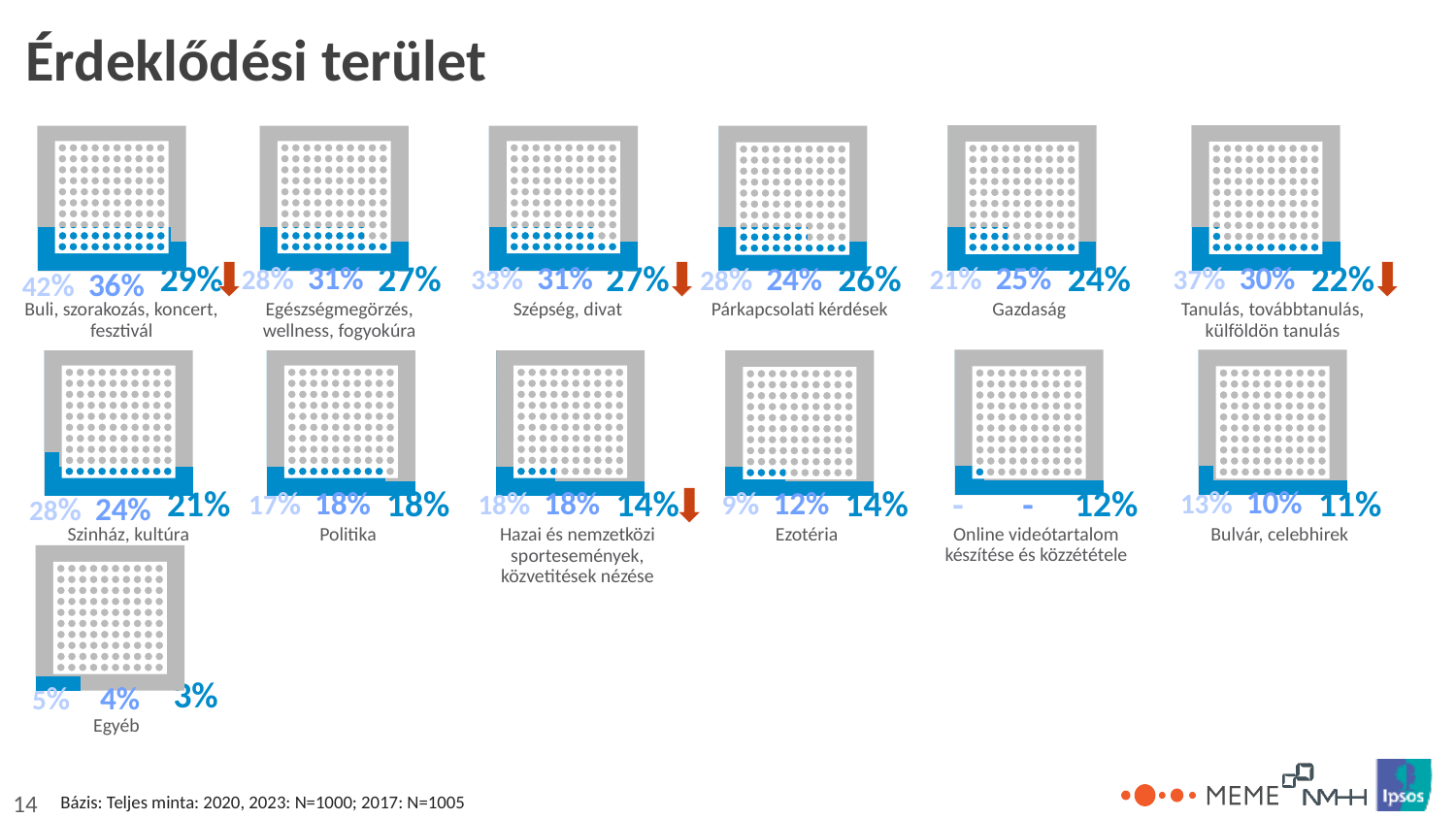
What is the rightmost (bold) value shown for Gazdaság? 24% How many interest areas are marked with a red downward arrow? 4 What is the rightmost (bold) value shown for Ezotéria? 14% Which interest area has the lowest rightmost (bold) value? Egyéb What is the difference between the rightmost values for Buli, szórakozás, koncert, fesztivál (29%) and Egyéb (3%)? 26 percentage points What is the leftmost value shown for Politika? 17% Which interest area has the highest rightmost (bold) value? Buli, szórakozás, koncert, fesztivál Which interest area shows a dash instead of a value for its first two figures? Online videótartalom készítése és közzététele Which has the larger rightmost value: Szépség, divat or Párkapcsolati kérdések? Szépség, divat Do the three values for Buli, szórakozás, koncert, fesztivál rise or fall from left to right? Fall What kind of chart is used to show each interest area? Pictograph (waffle chart of dots) How many interest areas are shown on the slide? 13